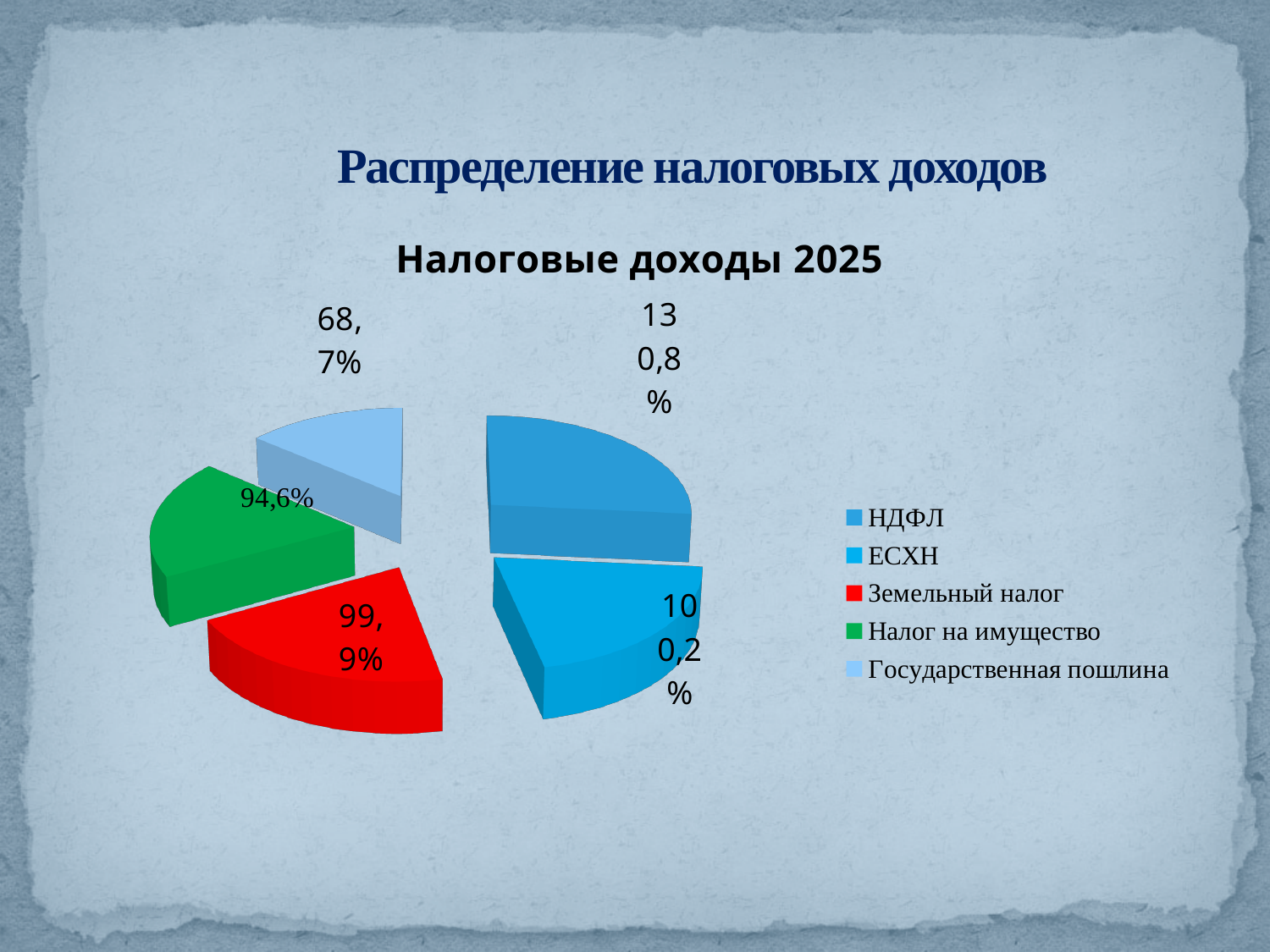
How many entries does the legend list? 5 What value is labelled for ЕСХН? 100,2% How many slices does the pie chart have? 5 Which category has the highest labelled value? НДФЛ What is the difference between the labelled values for НДФЛ and ЕСХН? 30,6% What is the chart title shown above the pie? Налоговые доходы 2025 What value is labelled for Государственная пошлина? 68,7% What type of chart is shown on the slide? pie chart What value is labelled for Налог на имущество? 94,6% Which category has the lowest labelled value? Государственная пошлина What value is labelled for Земельный налог? 99,9% What value is labelled for НДФЛ? 130,8%